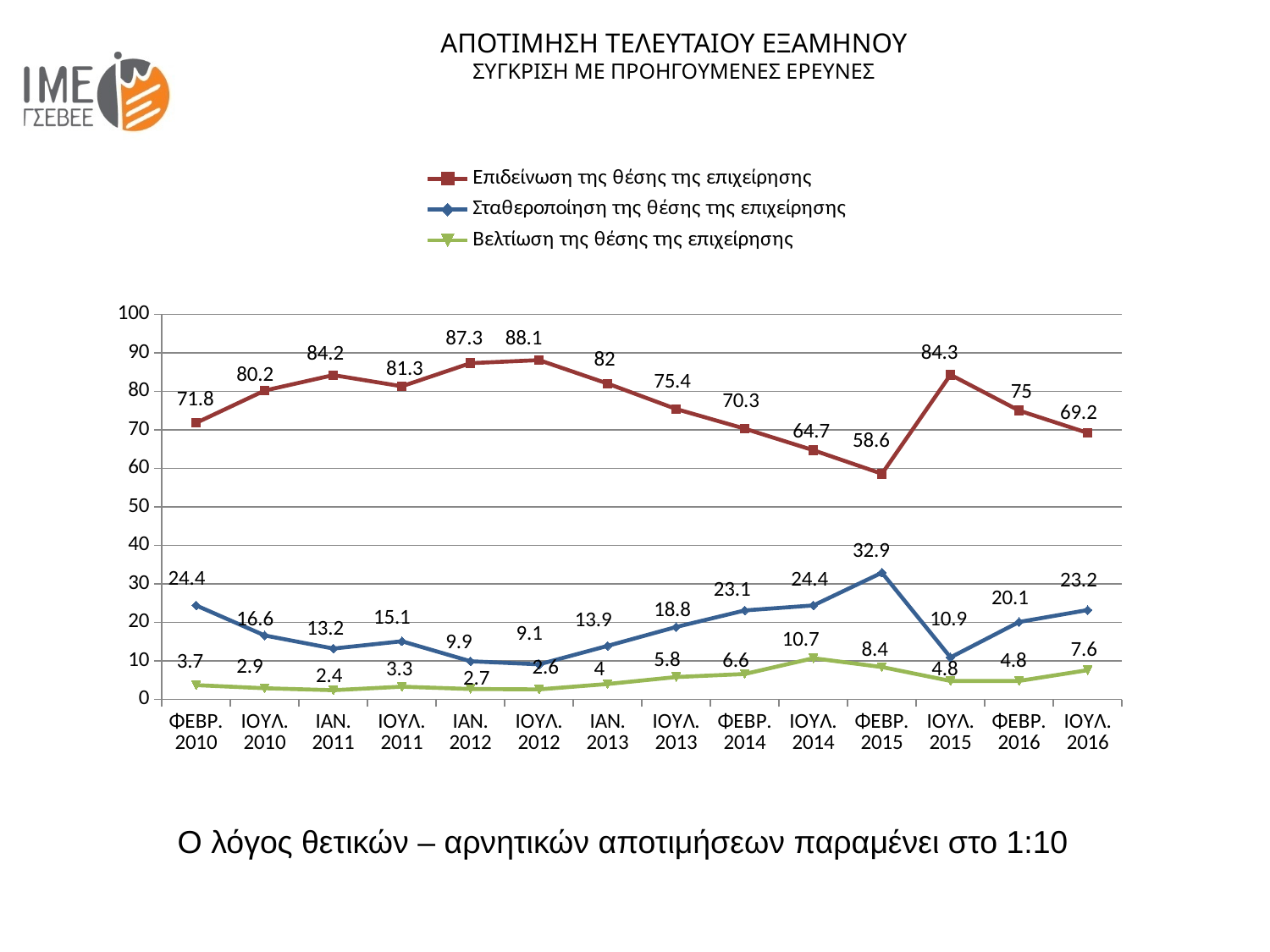
At which time point does Επιδείνωση της θέσης της επιχείρησης reach its lowest value? ΦΕΒΡ. 2015 What is the value of Βελτίωση της θέσης της επιχείρησης for ΙΟΥΛ. 2014? 10.7 What type of chart is shown on the slide? line chart By how much did Επιδείνωση της θέσης της επιχείρησης change from ΦΕΒΡ. 2015 to ΙΟΥΛ. 2015? 25.7 What is the value of Σταθεροποίηση της θέσης της επιχείρησης for ΦΕΒΡ. 2015? 32.9 How many time points are plotted along the x axis? 14 At which time point does Επιδείνωση της θέσης της επιχείρησης reach its highest value? ΙΟΥΛ. 2012 What is the value of Επιδείνωση της θέσης της επιχείρησης for ΙΟΥΛ. 2016? 69.2 What is the difference between Επιδείνωση and Σταθεροποίηση της θέσης της επιχείρησης in ΙΟΥΛ. 2016? 46 How many series does the legend list? 3 Which is larger in ΦΕΒΡ. 2010: Σταθεροποίηση or Βελτίωση της θέσης της επιχείρησης? Σταθεροποίηση της θέσης της επιχείρησης At which time point is Βελτίωση της θέσης της επιχείρησης lowest? ΙΑΝ. 2011